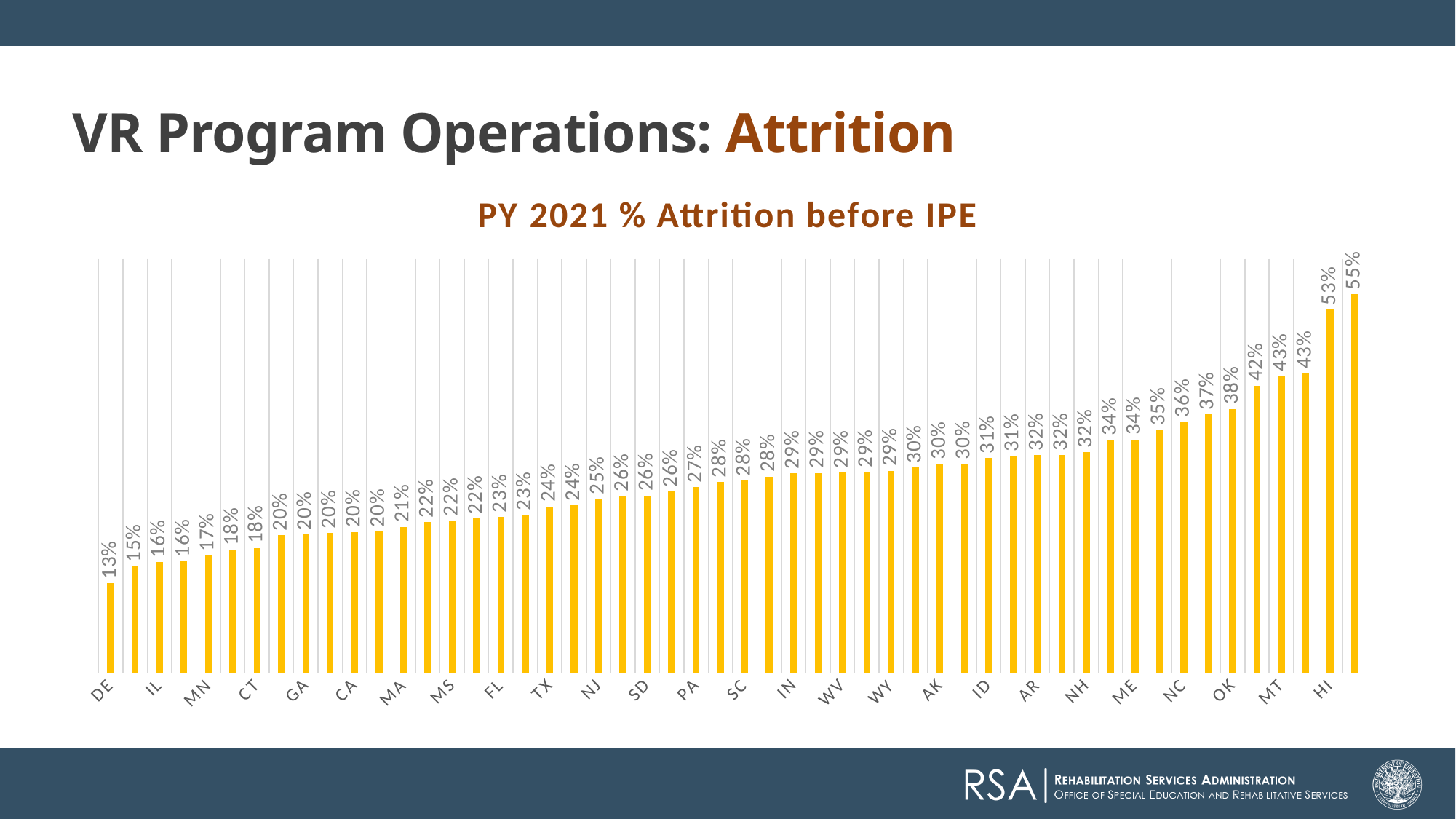
Which has a larger value, OK or ME? OK What is the attrition value for NC? 36% What is the attrition value for PA? 27% What is the attrition value for DE? 13% Do the values rise or fall from left to right along the x axis? rise What is the highest value shown on the chart? 55% What kind of chart is shown on the slide? bar chart Which state has the lowest attrition value? DE What is the difference between the values for HI and DE? 40 percentage points What is the attrition value for MT? 43% What is the attrition value for HI? 53% What is the title of the chart? PY 2021 % Attrition before IPE